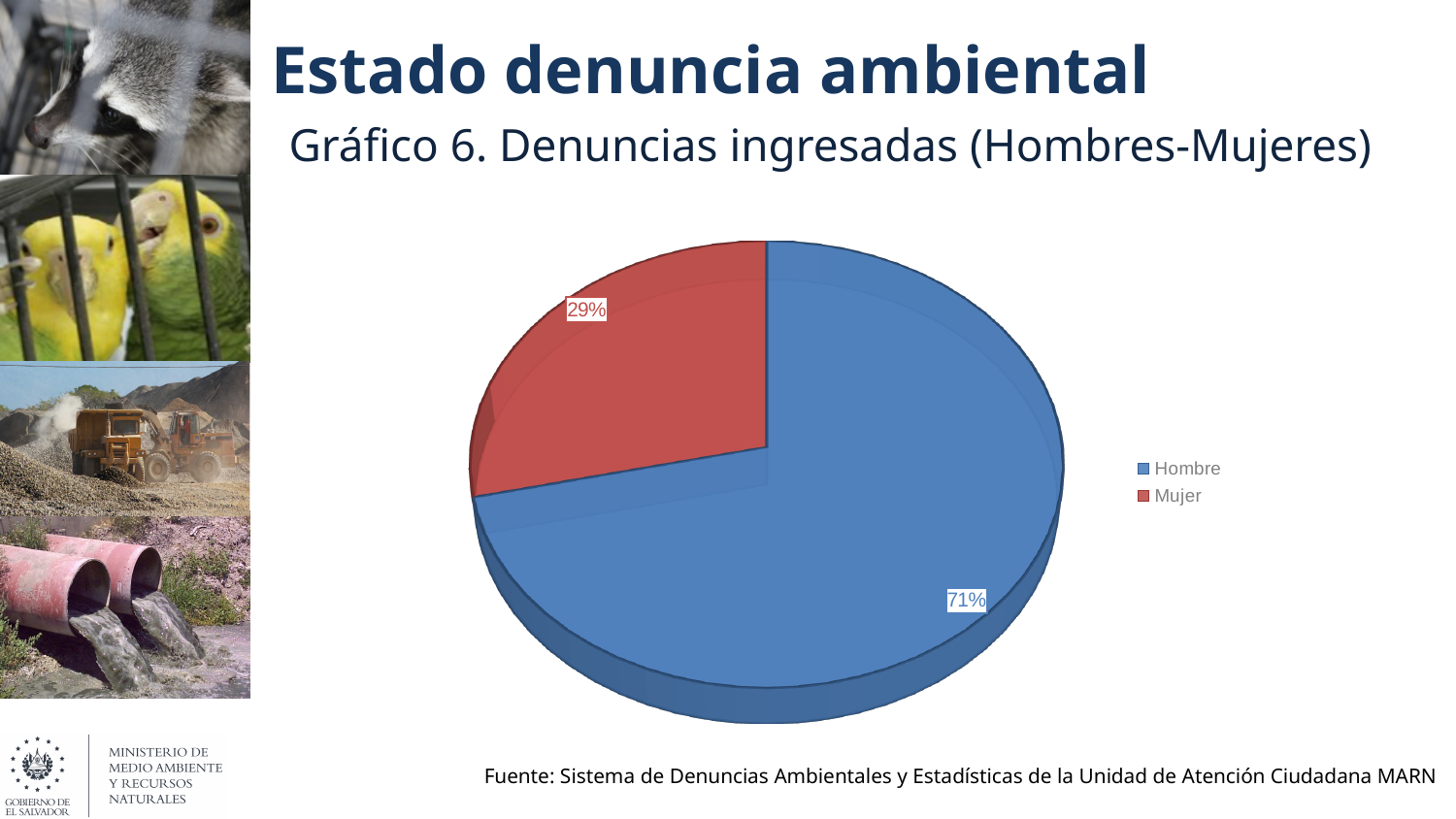
What share of the pie does Hombre represent? 71% Which is larger, the Hombre slice or the Mujer slice? Hombre What is the difference in percentage points between the Hombre and Mujer slices? 42 What is the title of the chart? Gráfico 6. Denuncias ingresadas (Hombres-Mujeres) What colour is the Mujer slice? Red Which category has the smallest slice of the pie? Mujer What share of the pie does Mujer represent? 29% How many categories does the pie chart show? 2 How many entries does the legend list? 2 What kind of chart is shown on the slide? Pie chart Which category has the largest slice of the pie? Hombre